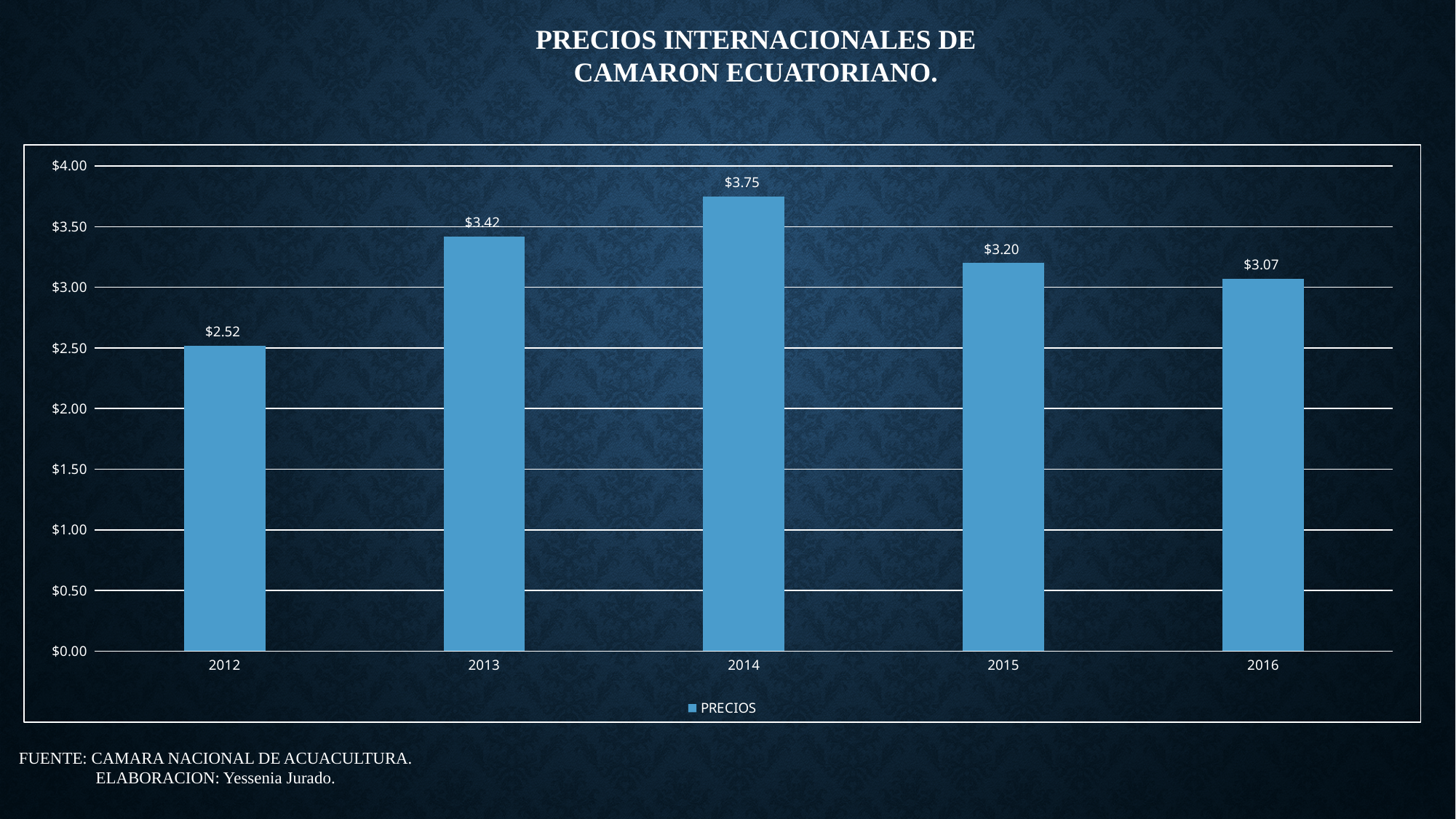
What kind of chart is shown on the slide? Bar chart What is the name of the series listed in the legend? PRECIOS What is the difference between the price in 2013 and the price in 2015? $0.22 Which year has a higher price, 2013 or 2015? 2013 What is the difference between the price in 2014 and the price in 2012? $1.23 What is the price for 2014? $3.75 Which year has the highest price? 2014 What is the price for 2012? $2.52 How many years are shown on the x axis? 5 What is the price for 2016? $3.07 Which year has the lowest price? 2012 Is the value for 2015 greater or less than $3.00? greater